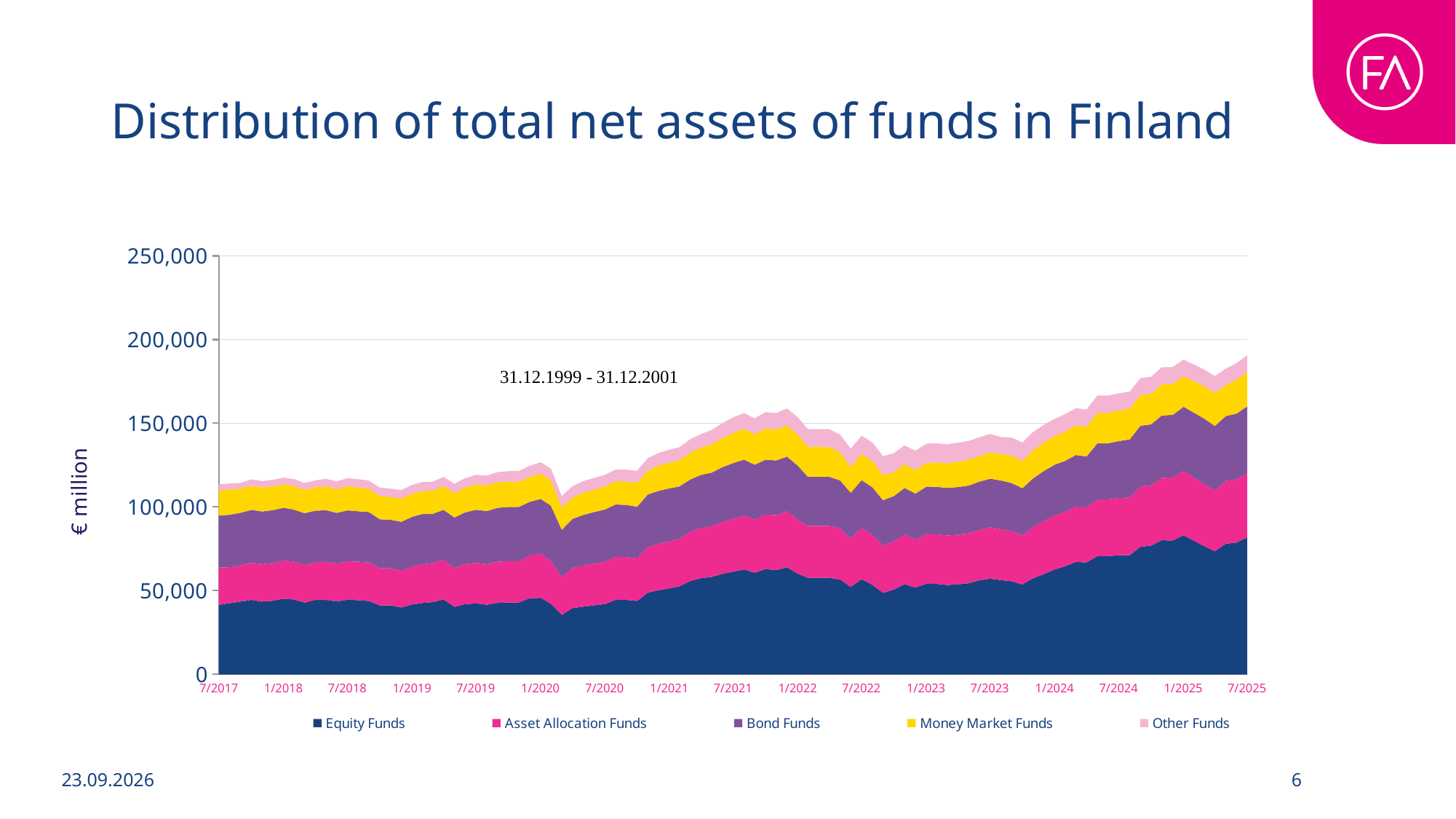
How many series does the legend list? 5 Is the value for Equity Funds at 7/2025 greater or less than 50,000? greater What is the label on the vertical axis? € million Which series is shown in yellow? Money Market Funds Is the total net assets of all funds at 7/2025 greater or less than 150,000? greater What kind of chart is shown on the slide? Stacked area chart What is the title of the chart? Distribution of total net assets of funds in Finland Does the total net assets of all funds rise or fall between 7/2017 and 7/2025? Rise Which series has the largest net assets at 7/2025? Equity Funds How many date labels are shown on the x axis? 17 Is the total net assets of all funds at 7/2017 greater or less than 150,000? less Which series has the smallest net assets at 7/2025? Other Funds